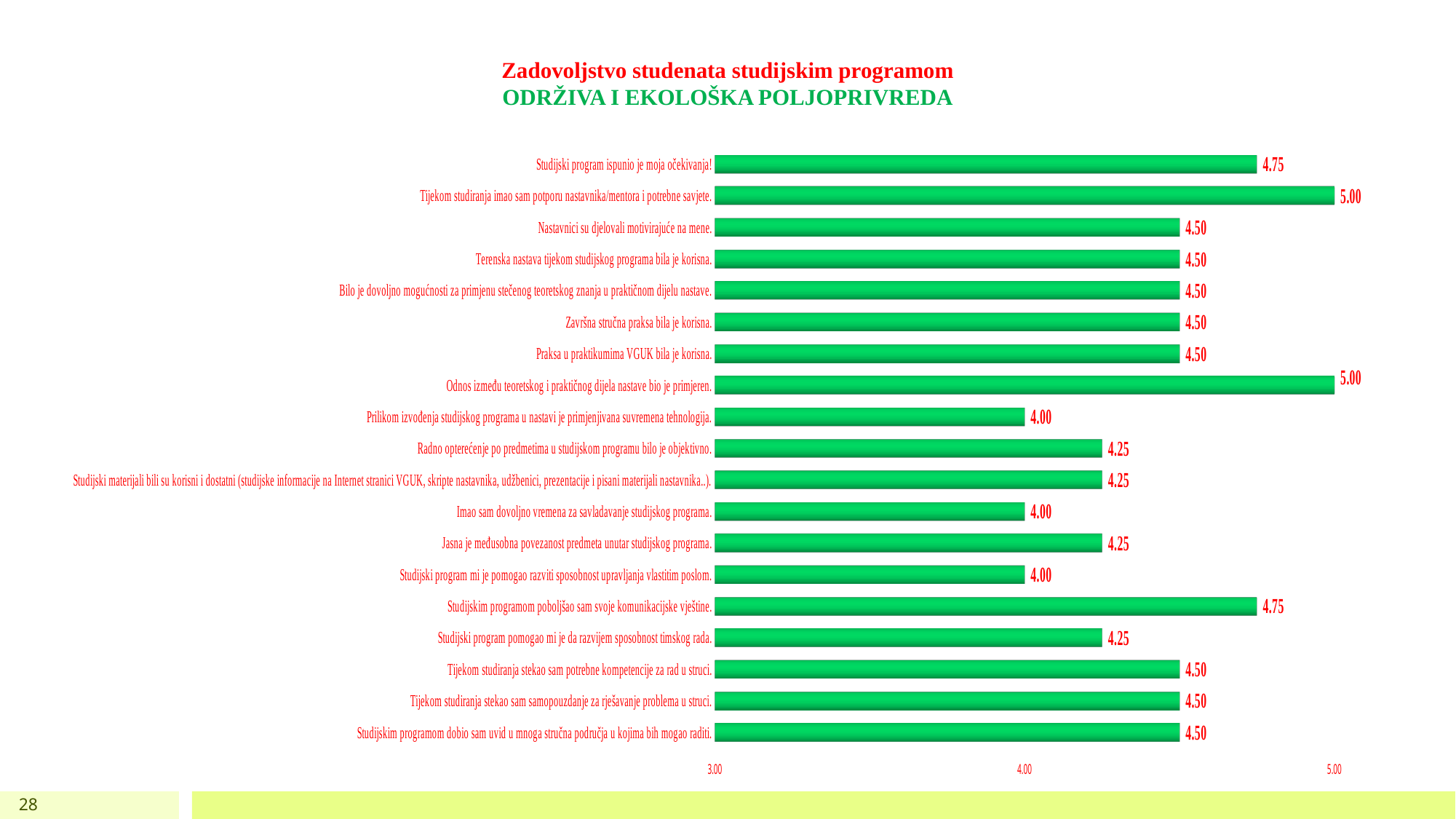
What is the value for "Studijski program ispunio je moja očekivanja!"? 4.75 What is the title of the chart? Zadovoljstvo studenata studijskim programom ODRŽIVA I EKOLOŠKA POLJOPRIVREDA What is the highest value shown on the x axis? 5.00 What kind of chart is shown on the slide? bar chart Which has a higher value: "Studijskim programom poboljšao sam svoje komunikacijske vještine." or "Studijski program pomogao mi je da razvijem sposobnost timskog rada."? Studijskim programom poboljšao sam svoje komunikacijske vještine. What is the value for "Radno opterećenje po predmetima u studijskom programu bilo je objektivno."? 4.25 What is the value for "Tijekom studiranja imao sam potporu nastavnika/mentora i potrebne savjete."? 5.00 What is the value for "Studijskim programom dobio sam uvid u mnoga stručna područja u kojima bih mogao raditi."? 4.50 Is the value for "Nastavnici su djelovali motivirajuće na mene." greater or less than 4.00? greater How many statements (bars) are shown in the chart? 19 What is the difference between the value for "Odnos između teoretskog i praktičnog dijela nastave bio je primjeren." and the value for "Imao sam dovoljno vremena za savladavanje studijskog programa."? 1.00 What is the value for "Prilikom izvođenja studijskog programa u nastavi je primjenjivana suvremena tehnologija."? 4.00